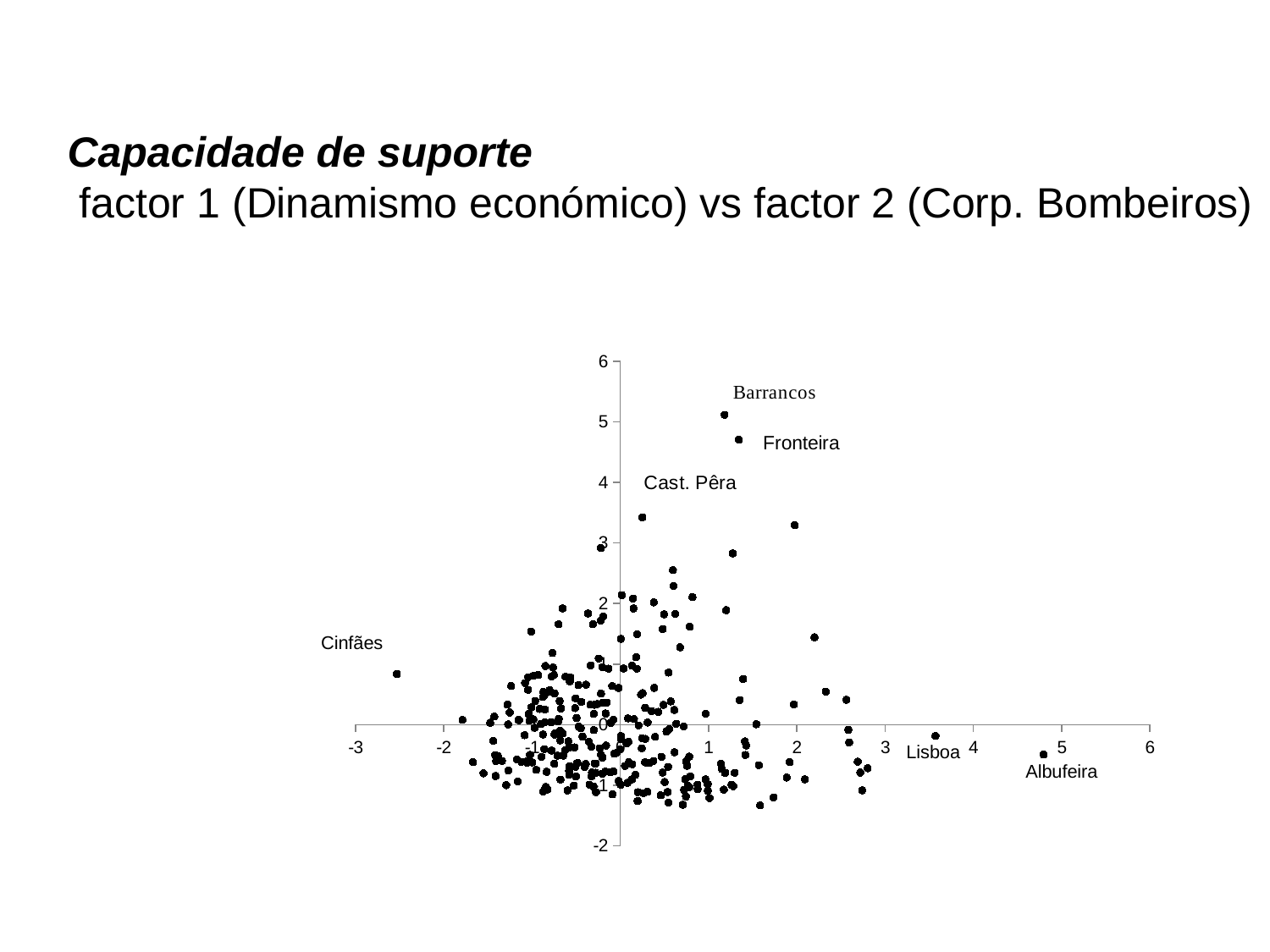
Which labeled point has the highest value on the horizontal axis? Albufeira Is the vertical-axis value for Barrancos greater or less than 4? greater Which labeled point is higher on the vertical axis, Barrancos or Fronteira? Barrancos Is the horizontal-axis value for Albufeira greater or less than 4? greater Which labeled point has the lowest value on the horizontal axis? Cinfães Which labeled point has the highest value on the vertical axis? Barrancos Is the horizontal-axis value for Cinfães greater or less than -2? less What kind of chart is shown on the slide? scatter plot What is the highest tick value shown on the horizontal axis? 6 Which labeled point is further right on the horizontal axis, Lisboa or Albufeira? Albufeira How many points on the scatter plot are labeled with a name? 6